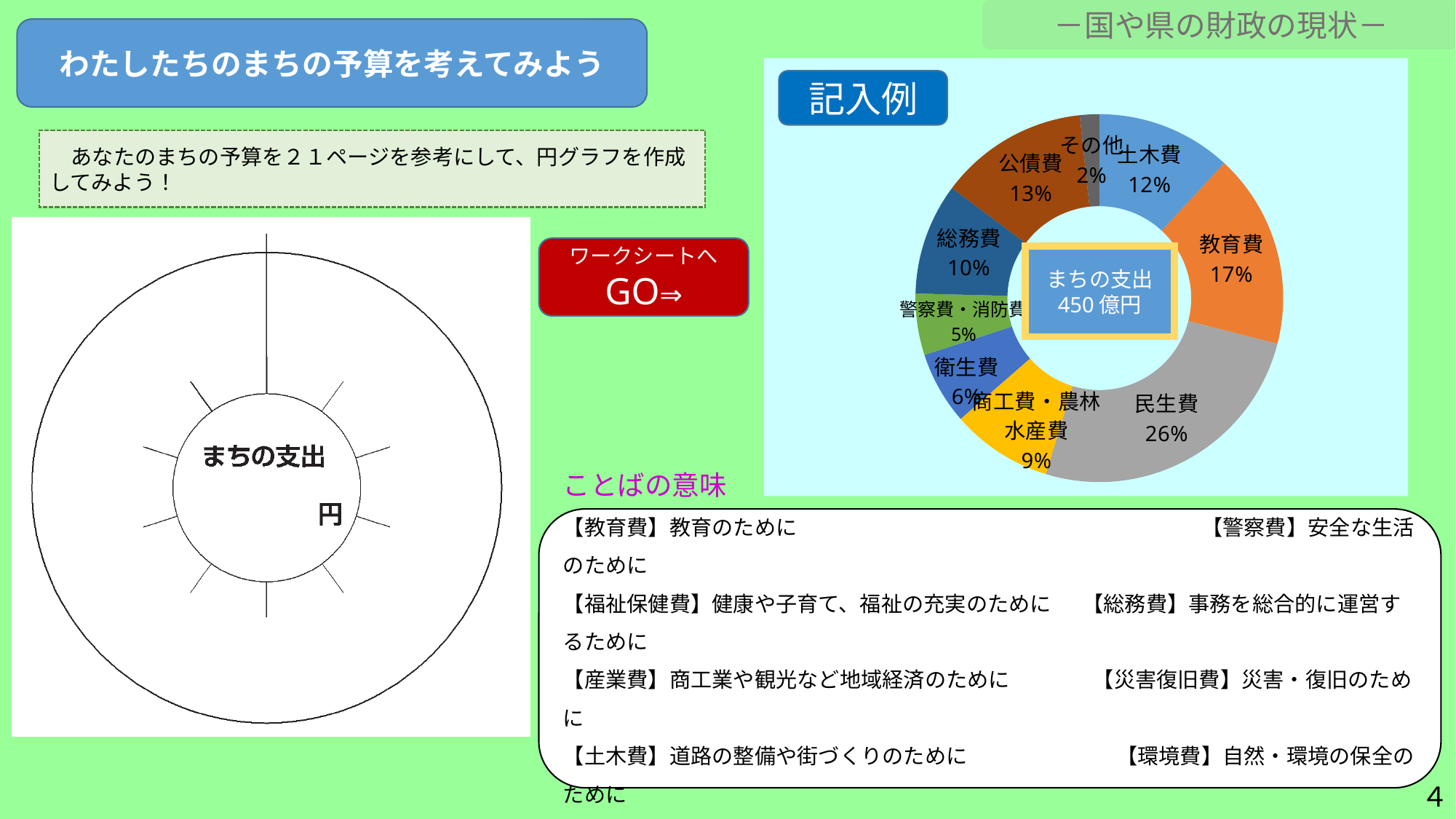
In the 記入例 doughnut chart, what share is 教育費? 17% In the 記入例 doughnut chart, what is the combined share of 衛生費 and 商工費・農林水産費? 15% In the 記入例 doughnut chart, what share is 民生費? 26% In the 記入例 doughnut chart, which category has the largest share? 民生費 What kind of chart is the 記入例 chart on the right of the slide? Doughnut chart In the 記入例 doughnut chart, which category has the smallest share? その他 In the 記入例 doughnut chart, what is the difference in percentage points between 民生費 and 教育費? 9 In the 記入例 doughnut chart, what share is 警察費・消防費? 5% In the 記入例 doughnut chart, what share is 公債費? 13% How many categories does the 記入例 doughnut chart show? 9 What total amount is shown in the centre of the 記入例 doughnut chart? 450 億円 In the 記入例 doughnut chart, which is larger, 土木費 or 総務費? 土木費